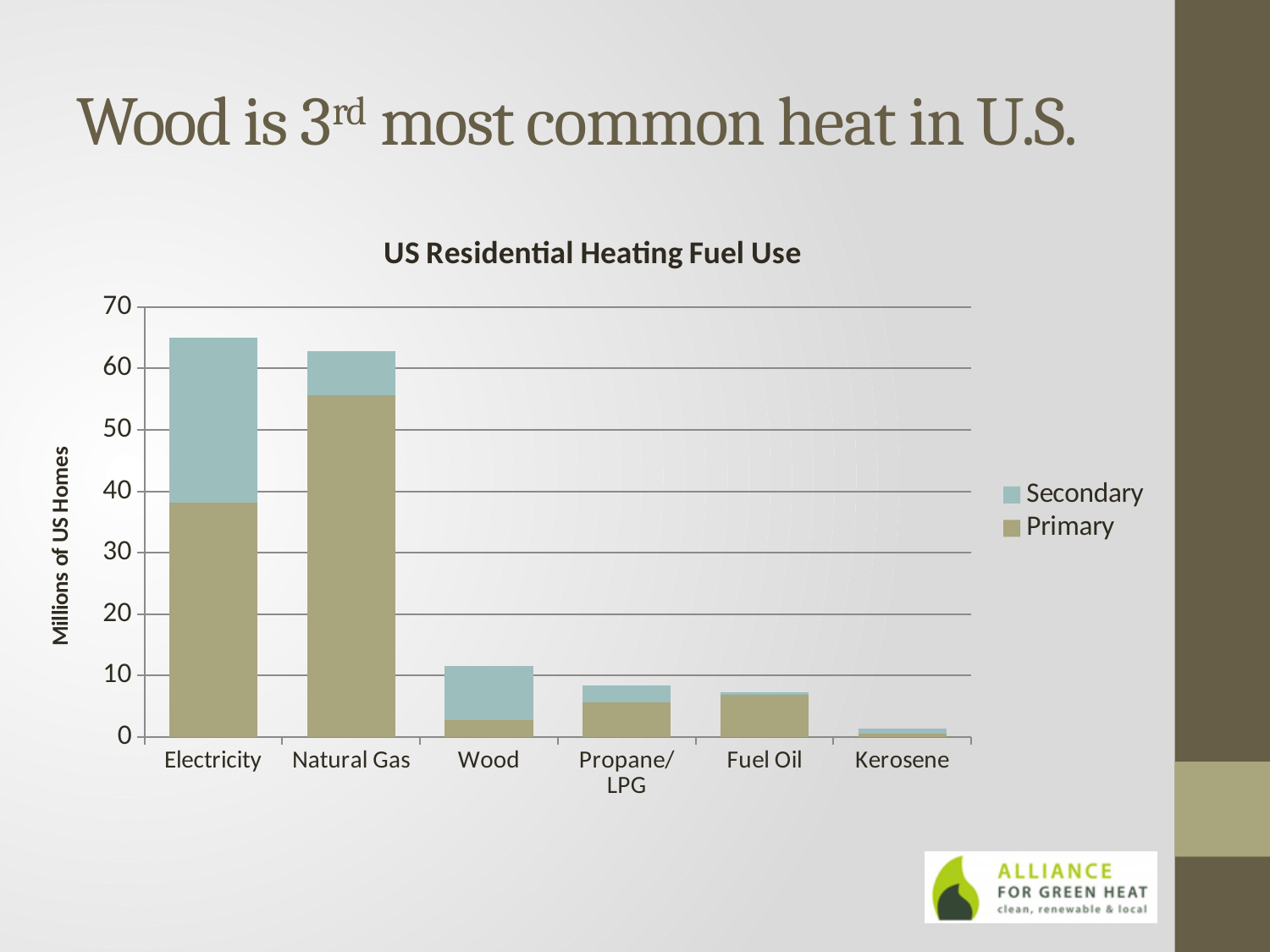
What is the label on the vertical axis of the chart? Millions of US Homes Which is larger, the total for Wood or the total for Propane/LPG? Wood How many fuel categories are shown on the x axis? 6 What type of chart is shown on the slide? Stacked bar chart Which fuel has the lowest total bar? Kerosene Which fuel has the largest Primary segment? Natural Gas Is the Primary value for Natural Gas greater or less than 50? greater Is the total value for Electricity greater or less than 60? greater How many series does the legend list? 2 What is the title of the chart? US Residential Heating Fuel Use Which is larger, the Primary value for Electricity or the Primary value for Natural Gas? Natural Gas Is the total value for Wood greater or less than 10? greater